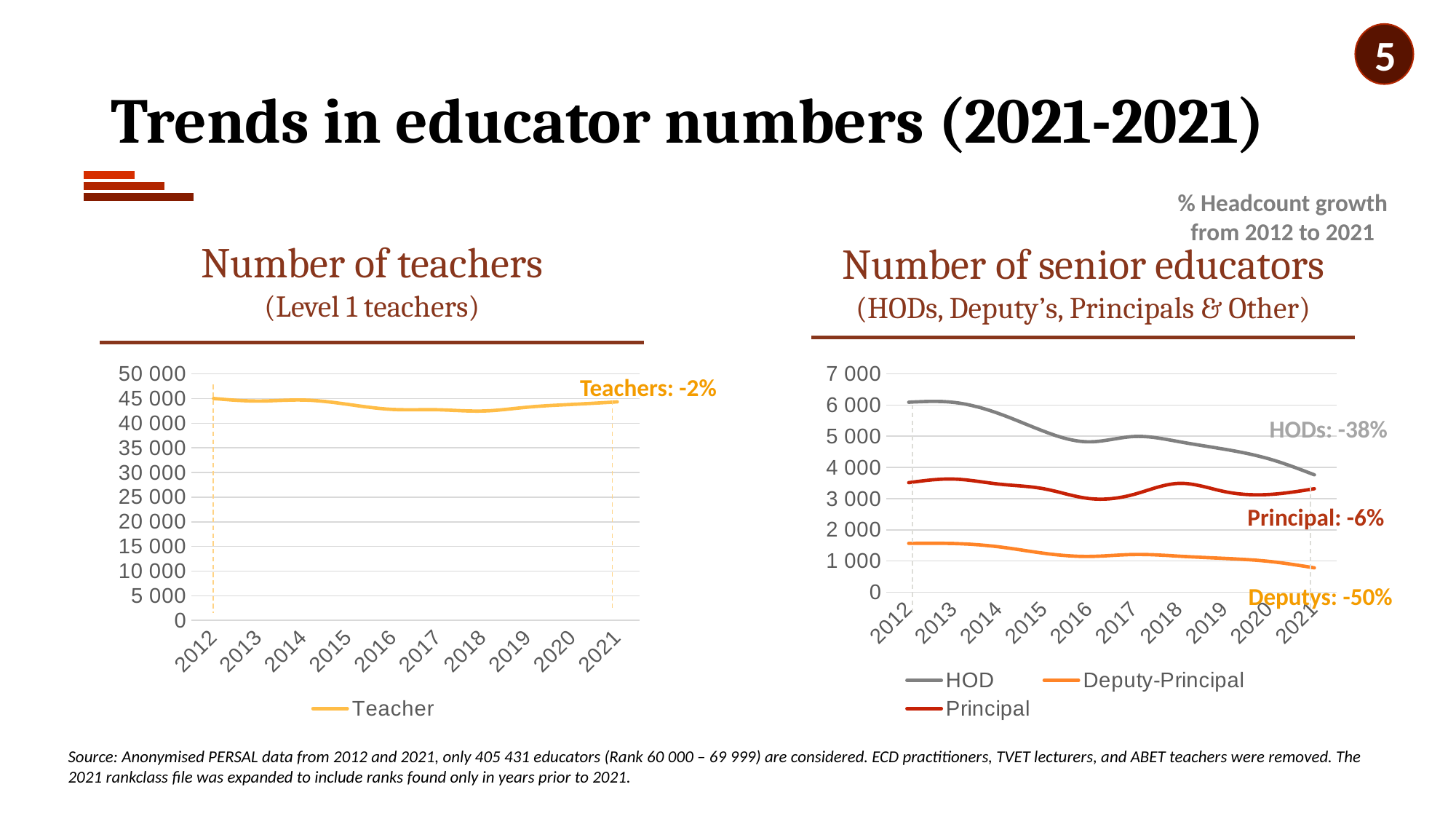
In the 'Number of senior educators' chart, is the HOD value for 2021 greater or less than 4 000? less In the 'Number of senior educators' chart, which series has the lowest values across the years? Deputy-Principal What percentage headcount growth from 2012 to 2021 is annotated for HODs on the 'Number of senior educators' chart? -38% How many years are plotted along the x axis of the 'Number of teachers' chart? 10 How many series does the legend of the 'Number of senior educators' chart list? 3 In the 'Number of teachers' chart, is the Teacher value for 2012 greater or less than 40 000? greater In the 'Number of senior educators' chart, does the HOD series rise or fall from 2012 to 2021? fall In the 'Number of senior educators' chart, which series has the highest values across the years? HOD In the 'Number of senior educators' chart, is the Deputy-Principal value for 2021 greater or less than 1 000? less What kind of chart is the 'Number of teachers' chart? line chart In the 'Number of senior educators' chart, which is larger in 2021: the Principal value or the Deputy-Principal value? Principal